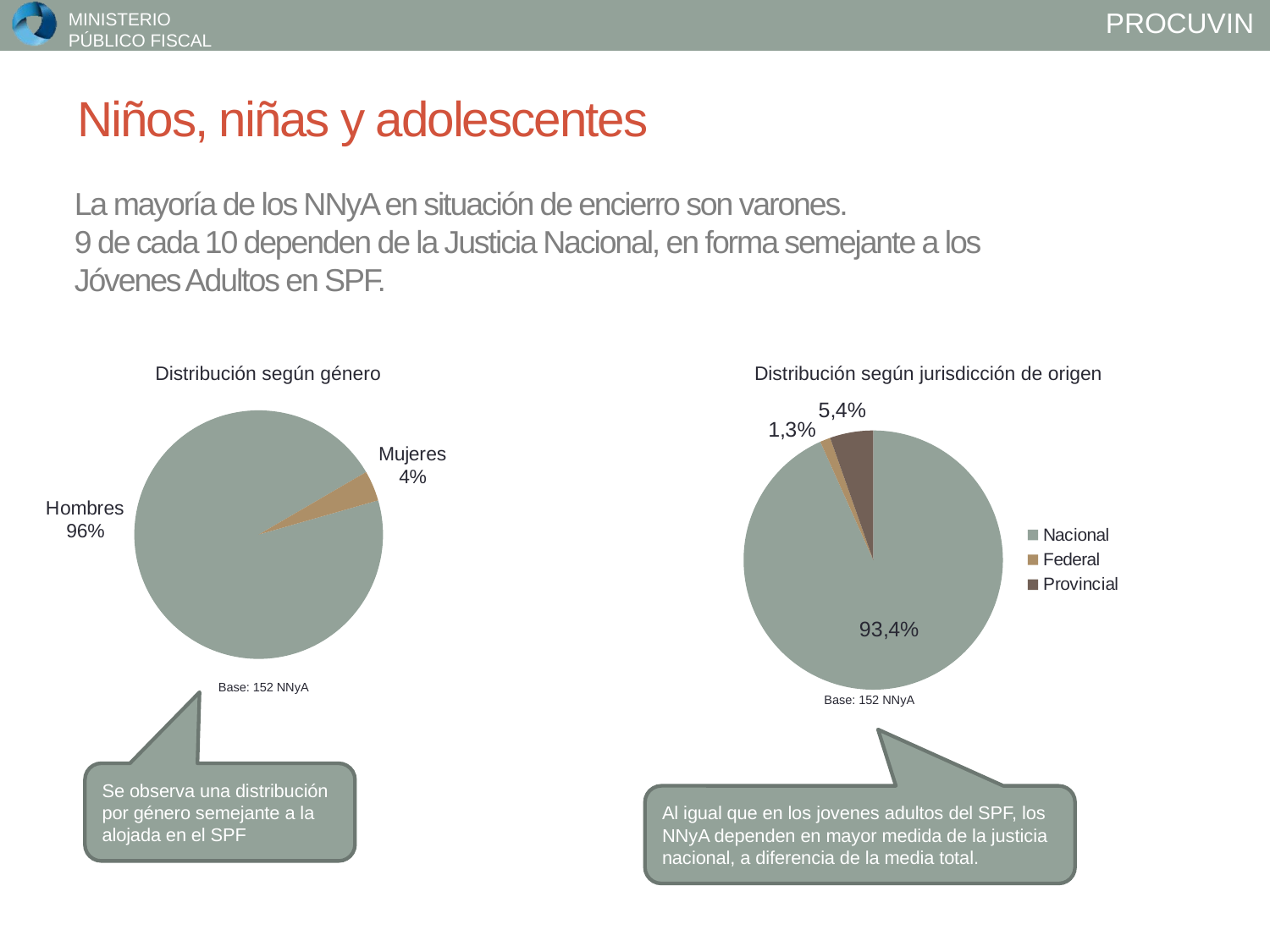
What kind of chart is 'Distribución según género'? Pie chart In the 'Distribución según género' chart, what share is Mujeres? 4% In the 'Distribución según género' chart, how many slices does the pie have? 2 In the 'Distribución según jurisdicción de origen' chart, how many entries does the legend list? 3 In the 'Distribución según jurisdicción de origen' chart, which is larger, Provincial or Federal? Provincial In the 'Distribución según jurisdicción de origen' chart, what is the difference between the Provincial and Federal shares? 4,1% In the 'Distribución según jurisdicción de origen' chart, what share is Federal? 1,3% In the 'Distribución según jurisdicción de origen' chart, what share is Provincial? 5,4% In the 'Distribución según jurisdicción de origen' chart, which category has the smallest share? Federal In the 'Distribución según género' chart, what is the difference between the Hombres and Mujeres shares? 92% In the 'Distribución según género' chart, what share is Hombres? 96% In the 'Distribución según jurisdicción de origen' chart, what share is Nacional? 93,4%